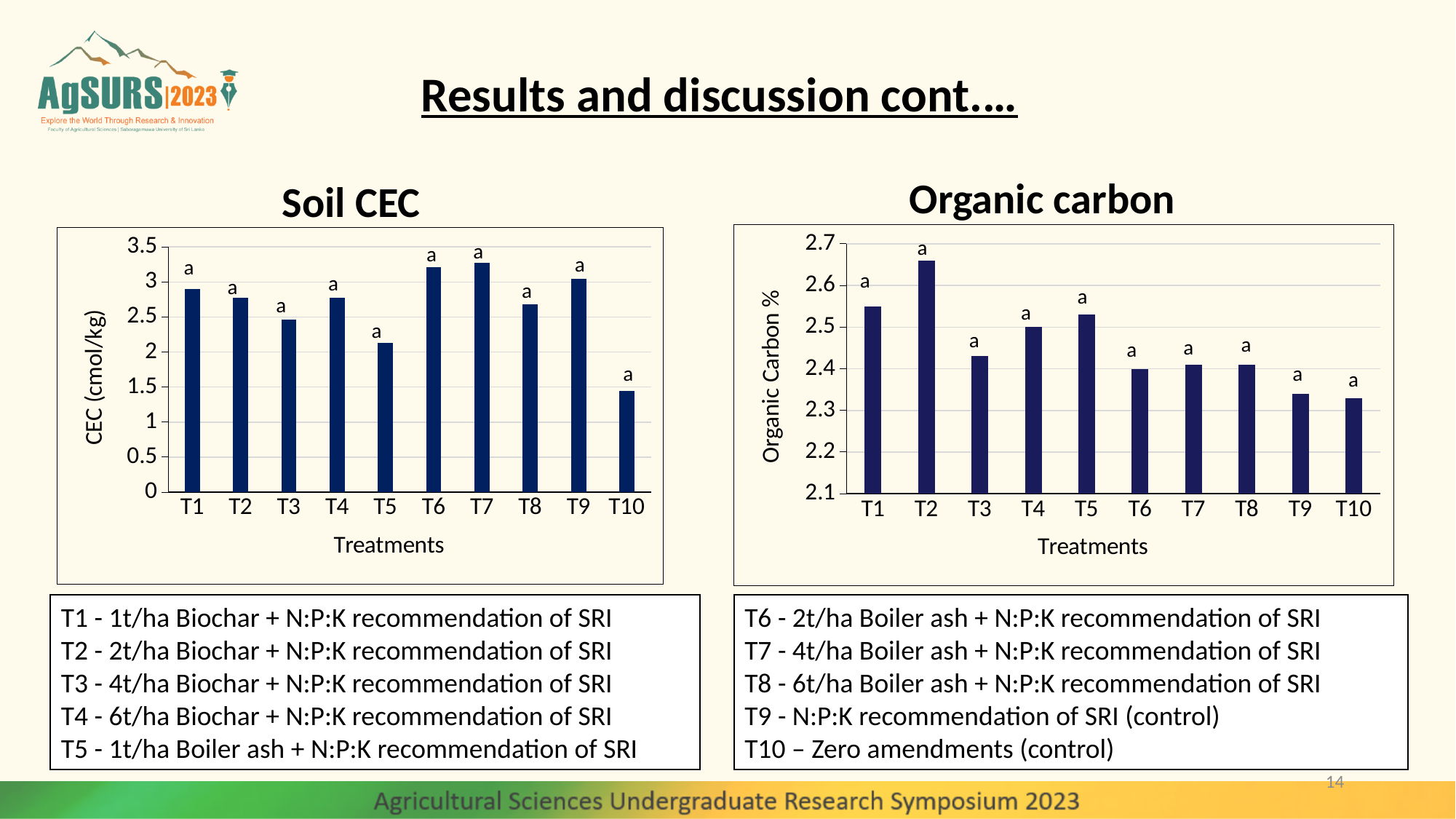
What type of chart is the Soil CEC chart? bar chart In the Organic carbon chart, which treatment has the highest organic carbon value? T2 In the Soil CEC chart, which treatment has the lowest CEC value? T10 In the Organic carbon chart, is the value for T2 greater or less than 2.6? greater In the Soil CEC chart, which has the larger value, T6 or T3? T6 In the Organic carbon chart, is the value for T9 greater or less than 2.4? less How many treatments are shown on the x axis of the Soil CEC chart? 10 In the Soil CEC chart, which treatment has the highest CEC value? T7 In the Organic carbon chart, which has the larger value, T1 or T6? T1 In the Soil CEC chart, is the value for T7 greater or less than 3? greater What is the y-axis label of the Soil CEC chart? CEC (cmol/kg)